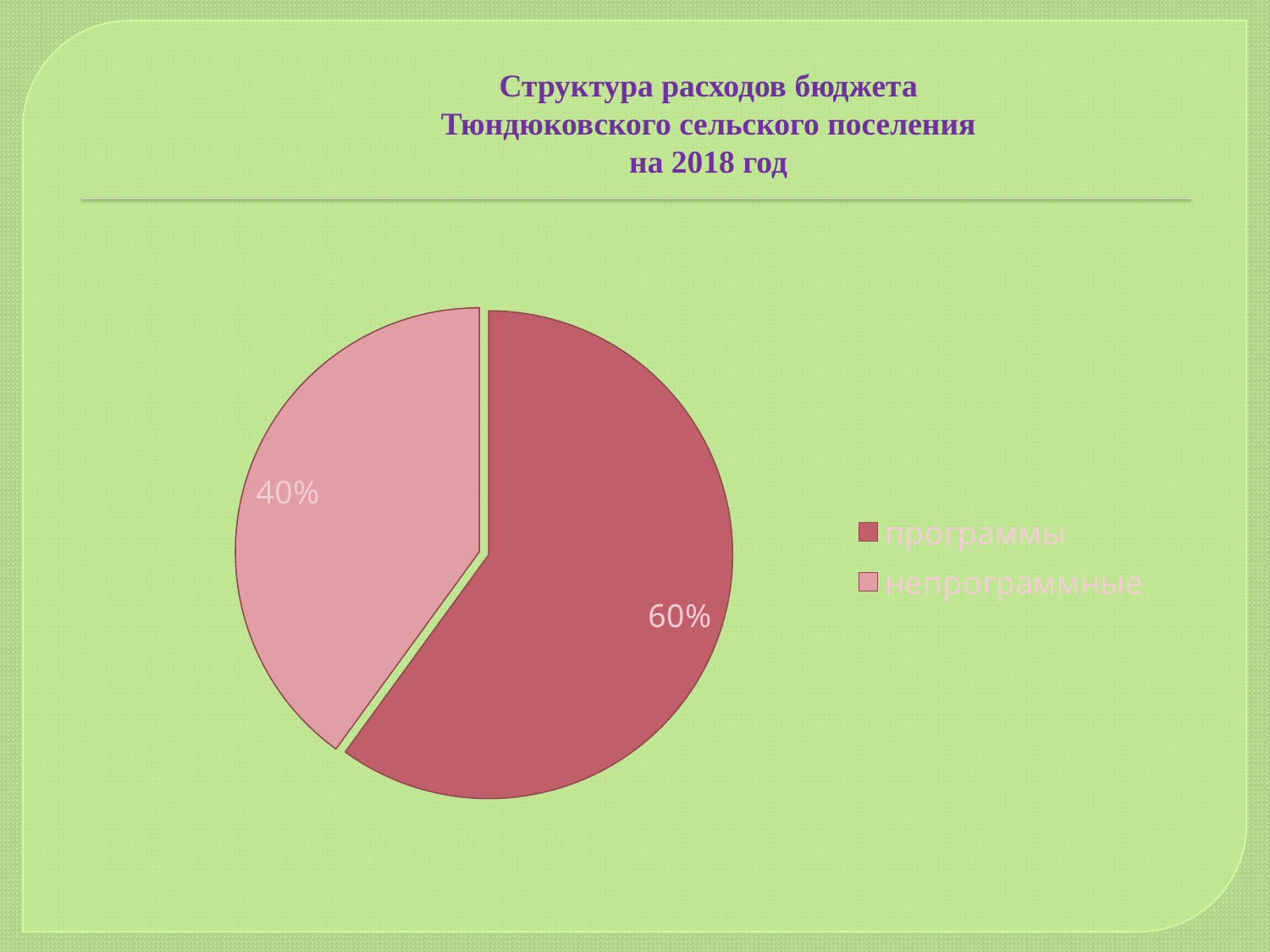
What share of the pie does the "непрограммные" slice represent? 40% Which slice is the smallest in the pie chart? непрограммные Which is larger: the "программы" slice or the "непрограммные" slice? программы Which year does the chart title refer to? 2018 Which legend entry is shown in the darker red colour? программы What kind of chart is shown on the slide? pie chart What is the difference in percentage points between the "программы" and "непрограммные" slices? 20% Which slice is the largest in the pie chart? программы What share of the pie does the "программы" slice represent? 60% How many slices does the pie chart have? 2 How many entries does the legend list? 2